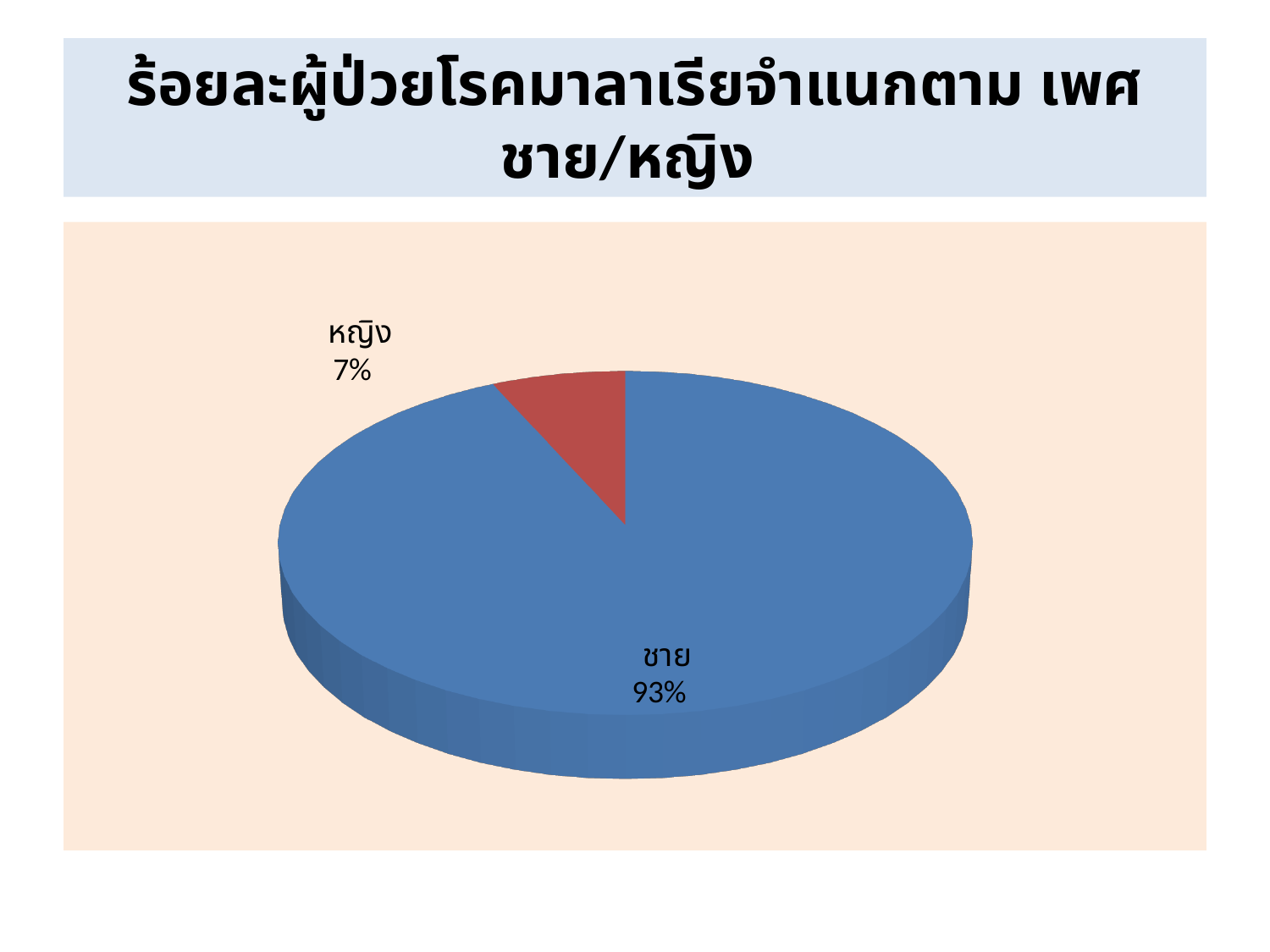
What kind of chart is shown on the slide? Pie chart Which category has the smallest share of the pie? หญิง What colour is the slice for ชาย? Blue What percentage of malaria patients are male (ชาย)? 93% Which category has the largest share of the pie? ชาย How many categories are shown in the pie chart? 2 What share of the pie does the หญิง slice represent? 7% What percentage of malaria patients are female (หญิง)? 7% What is the difference in percentage points between the male (ชาย) and female (หญิง) shares? 86 What colour is the slice for หญิง? Red Which is larger, the share for ชาย or the share for หญิง? ชาย